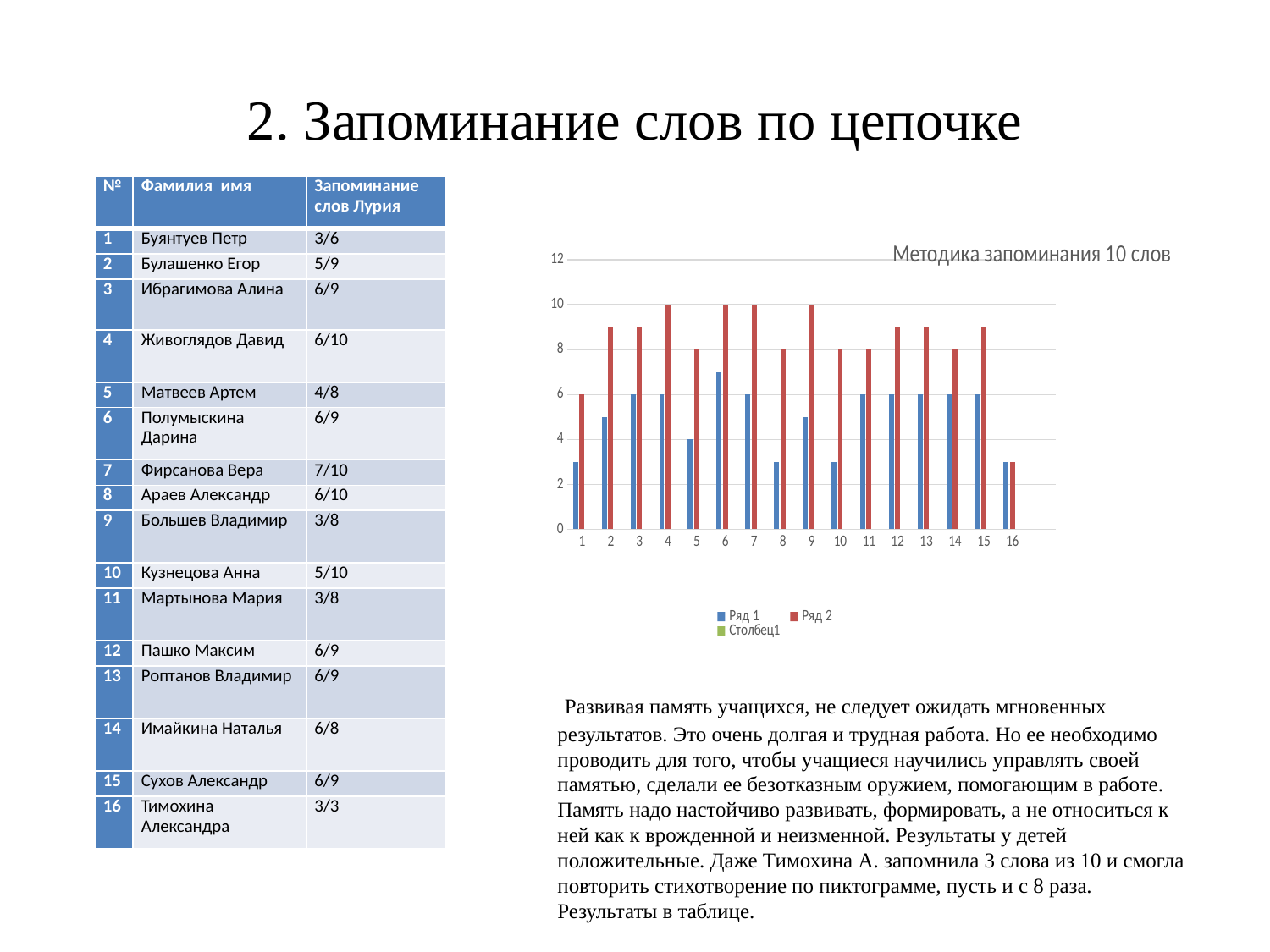
What kind of chart is shown on the slide? bar chart What is the difference between Ряд 2 and Ряд 1 for category 4? 4 How many categories are shown along the x axis of the chart? 16 What is the title of the chart? Методика запоминания 10 слов Which category has the highest value for Ряд 1? 6 For category 2, which series has the larger value, Ряд 1 or Ряд 2? Ряд 2 Which category has the lowest value for Ряд 2? 16 How many series does the chart legend list? 3 Is the value of Ряд 2 for category 2 greater or less than 8? greater What is the value of Ряд 1 for category 5? 4 What is the value of Ряд 2 for category 1? 6 What is the value of Ряд 2 for category 4? 10